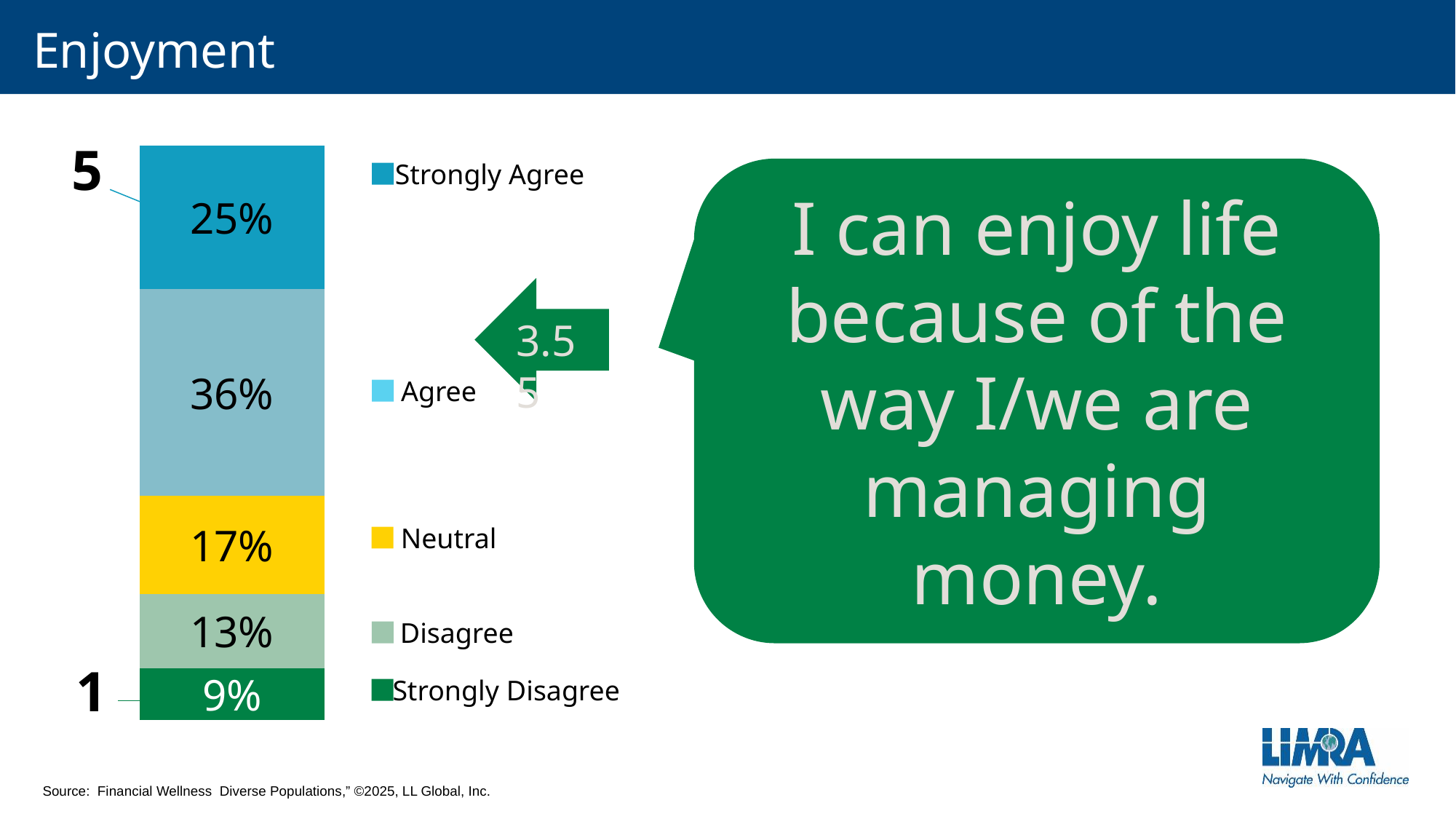
What kind of chart is shown on the slide? Stacked bar chart What is the difference in percentage points between Agree and Strongly Agree? 11 What colour represents the Neutral segment in the chart? Yellow What percentage of respondents selected Neutral? 17% What percentage of respondents selected Strongly Disagree? 9% Which is larger, the share for Neutral or the share for Disagree? Neutral How many response categories does the legend list? 5 What is the combined percentage of Strongly Agree and Agree? 61% Which response category has the largest share? Agree What percentage of respondents selected Agree? 36% Which response category has the smallest share? Strongly Disagree What average score is shown in the green arrow next to the chart? 3.5